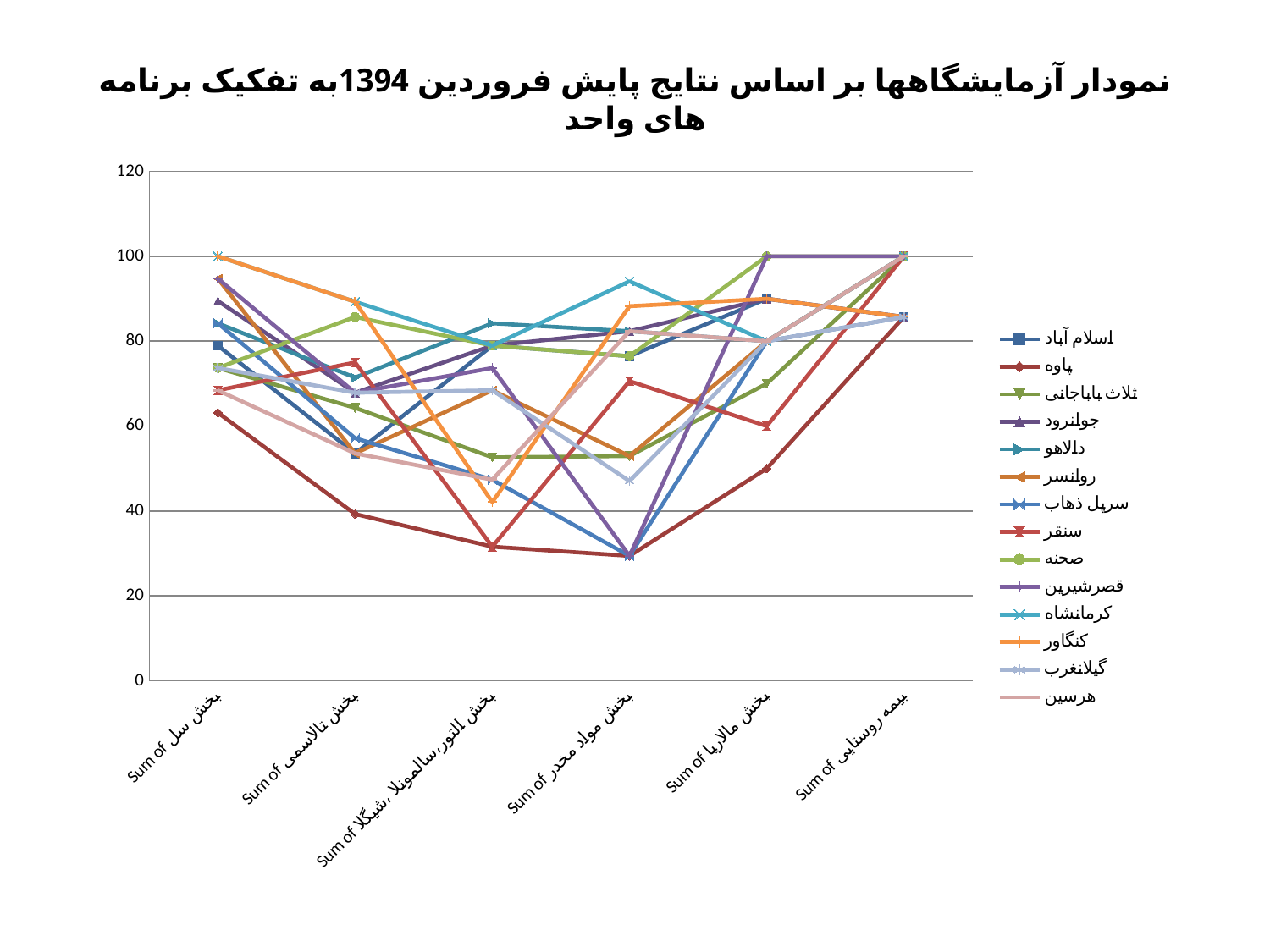
Which series has the lowest value at Sum of بخش تالاسمی? پاوه Does the value for پاوه rise or fall from Sum of بخش مالاریا to Sum of بیمه روستایی? rise How many categories are shown along the x axis? 6 Is the value for پاوه at Sum of بخش تالاسمی greater or less than 60? less Is the value for کرمانشاه at Sum of بخش مواد مخدر greater or less than 80? greater How many series does the legend list? 14 Is the value for پاوه at Sum of بخش مواد مخدر greater or less than 40? less Which series is listed first in the legend? اسلام آباد Does the value for پاوه rise or fall from Sum of بخش سل to Sum of بخش تالاسمی? fall What kind of chart is shown on the slide? line chart At Sum of بخش مواد مخدر, which is larger: the value for کرمانشاه or the value for پاوه? کرمانشاه